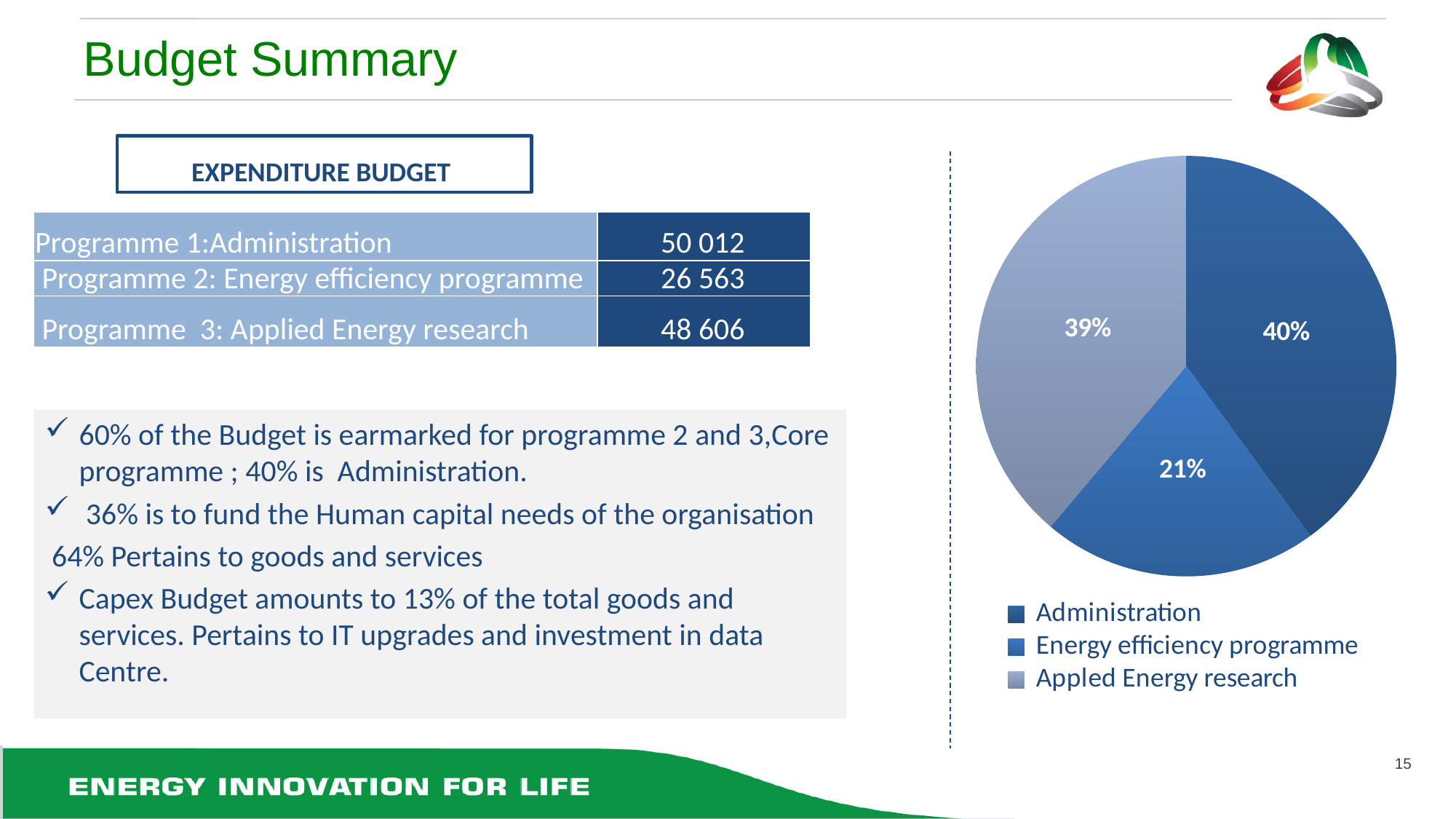
Which slice of the pie chart is the smallest? Energy efficiency programme What share of the pie chart is Appled Energy research? 39% What is the difference in percentage points between the Administration slice and the Energy efficiency programme slice? 19 What share of the pie chart is Administration? 40% Which slice of the pie chart is the largest? Administration Which is larger in the pie chart, Appled Energy research or Energy efficiency programme? Appled Energy research How many slices does the pie chart have? 3 What kind of chart is shown on the slide? pie chart What is the difference in percentage points between the Administration slice and the Appled Energy research slice? 1 How many entries does the pie chart legend list? 3 What share of the pie chart is the Energy efficiency programme? 21% Which legend entry of the pie chart is shown in the darkest blue? Administration